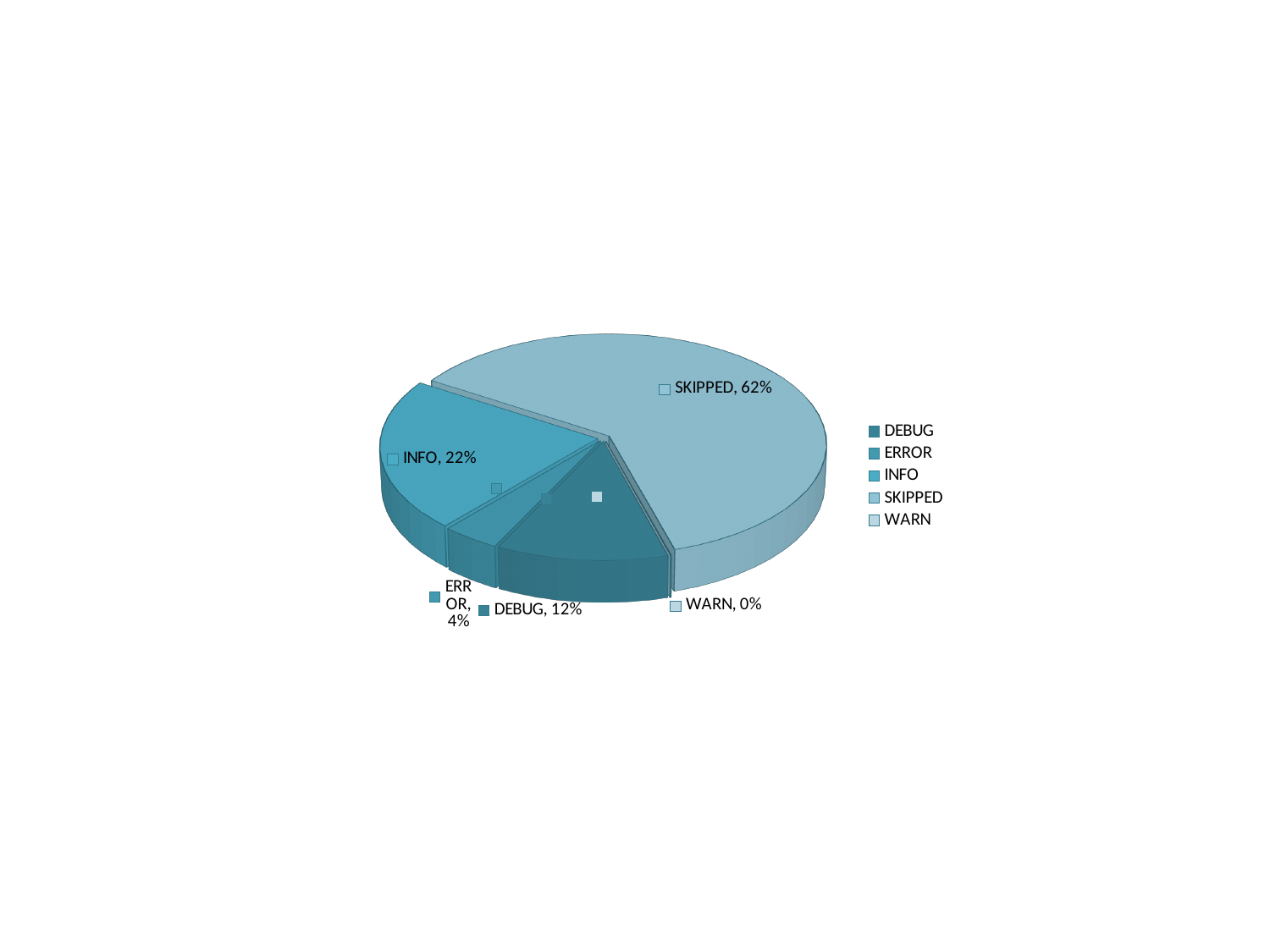
What share of the pie does DEBUG have? 12% What share of the pie does SKIPPED have? 62% Which category has the smallest slice of the pie? WARN What share of the pie does ERROR have? 4% What is the difference in percentage points between SKIPPED and INFO? 40 Which category has the largest slice of the pie? SKIPPED Which is larger, the INFO slice or the DEBUG slice? INFO How many categories does the legend list? 5 What kind of chart is shown on the slide? Pie chart What is the combined share of DEBUG and ERROR? 16%